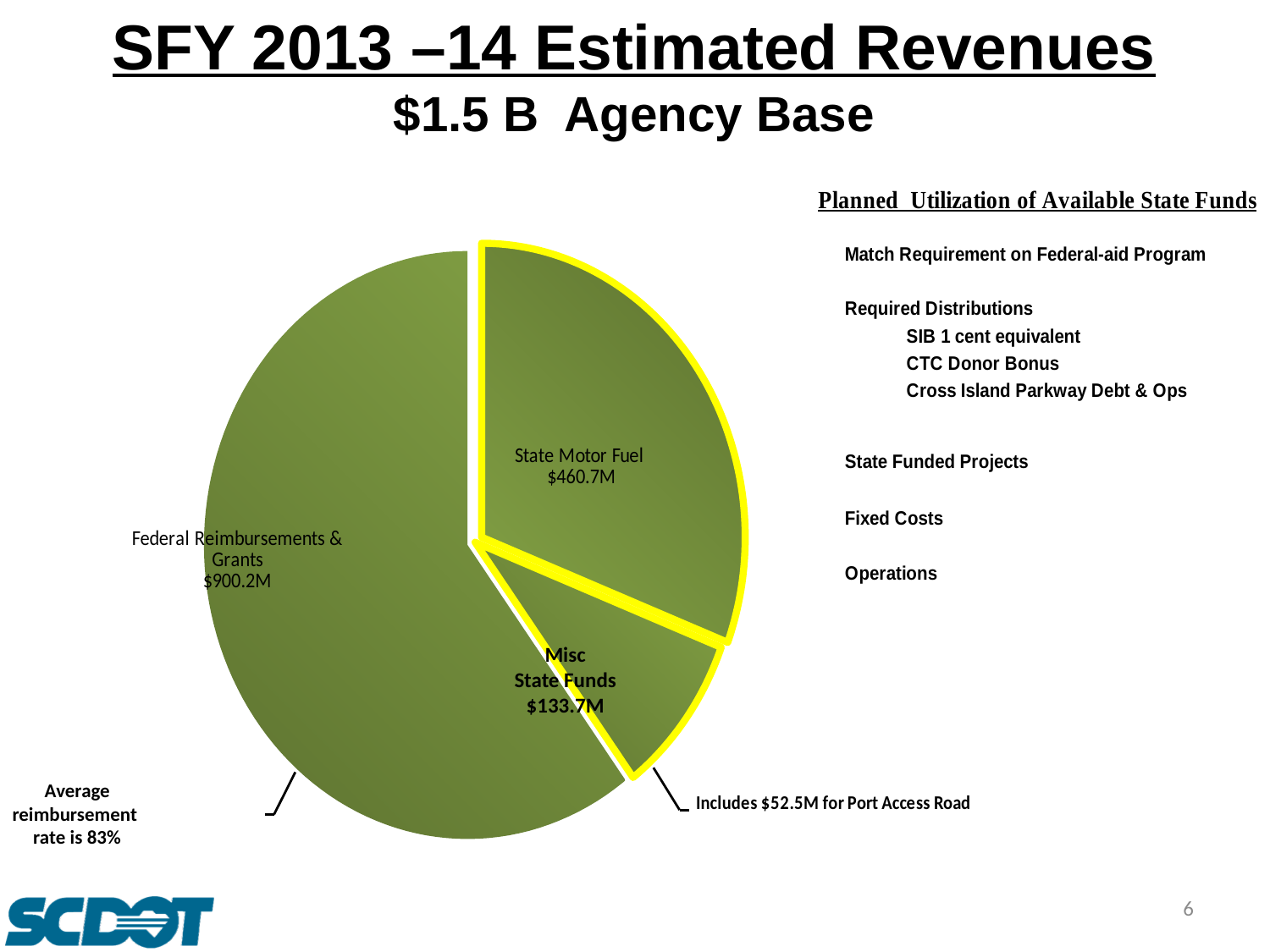
How many slices does the pie chart have? 3 What is the value for State Motor Fuel? $460.7M What type of chart is shown on the slide? Pie chart Which slice of the pie chart is the largest? Federal Reimbursements & Grants What is the difference between State Motor Fuel and Misc State Funds? $327.0M What is the value for Federal Reimbursements & Grants? $900.2M What is the combined total of the three slices in the pie chart? $1,494.6M Which slice of the pie chart is the smallest? Misc State Funds What is the value for Misc State Funds? $133.7M Which is larger, State Motor Fuel or Misc State Funds? State Motor Fuel According to the annotation on the slide, how much of the Misc State Funds slice is for Port Access Road? $52.5M What is the difference between Federal Reimbursements & Grants and State Motor Fuel? $439.5M